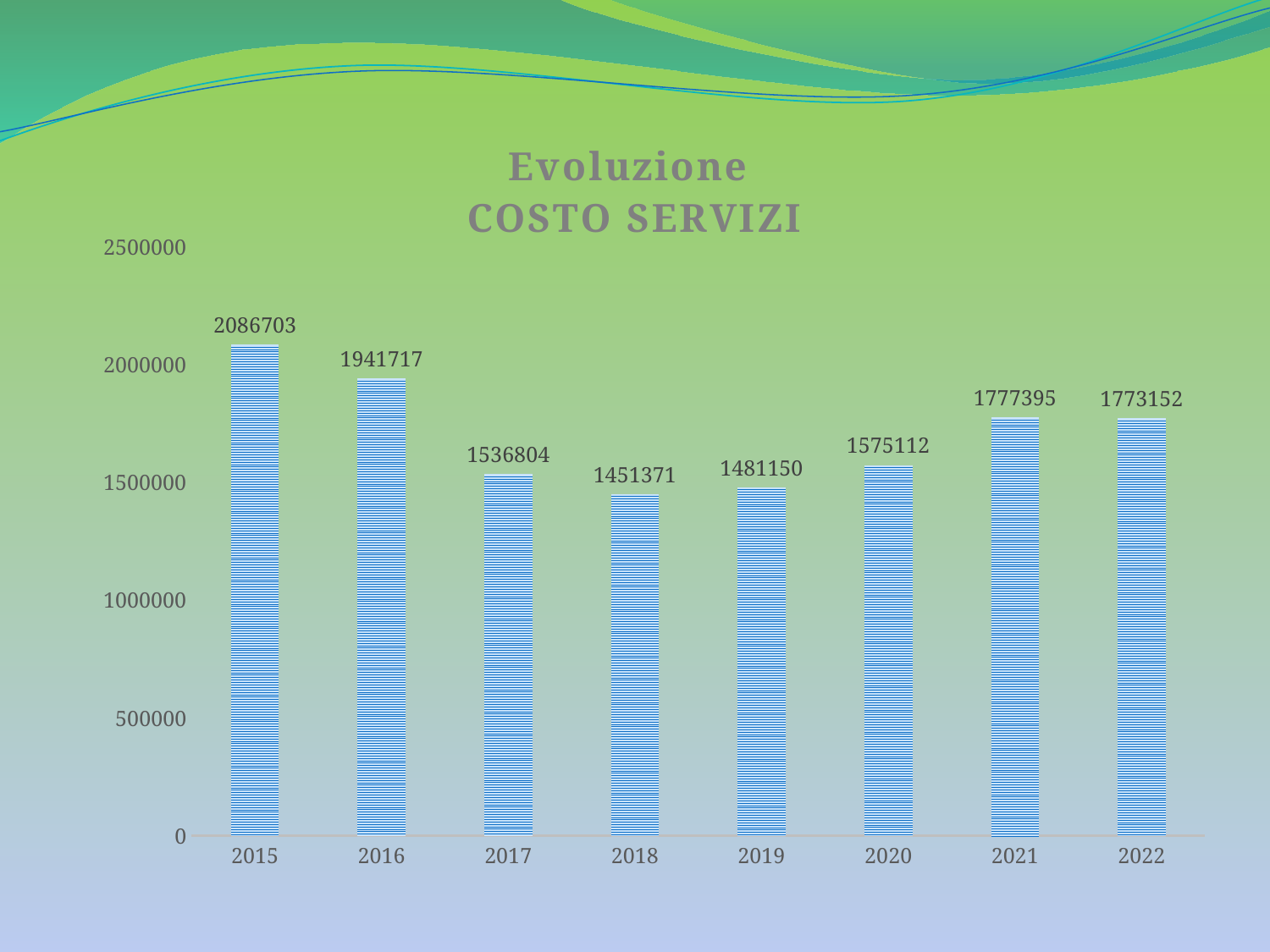
What is the difference between the values for 2015 and 2016? 144986 Is the value for 2017 greater or less than 1500000? greater What is the value for 2021? 1777395 Which year has the highest value? 2015 What is the value for 2015? 2086703 What is the difference between the values for 2021 and 2022? 4243 Do the values rise or fall from 2015 to 2018? fall What kind of chart is shown on the slide? bar chart Which is larger, the value for 2016 or the value for 2020? 2016 Which year has the lowest value? 2018 How many years are shown on the x axis? 8 What is the value for 2018? 1451371